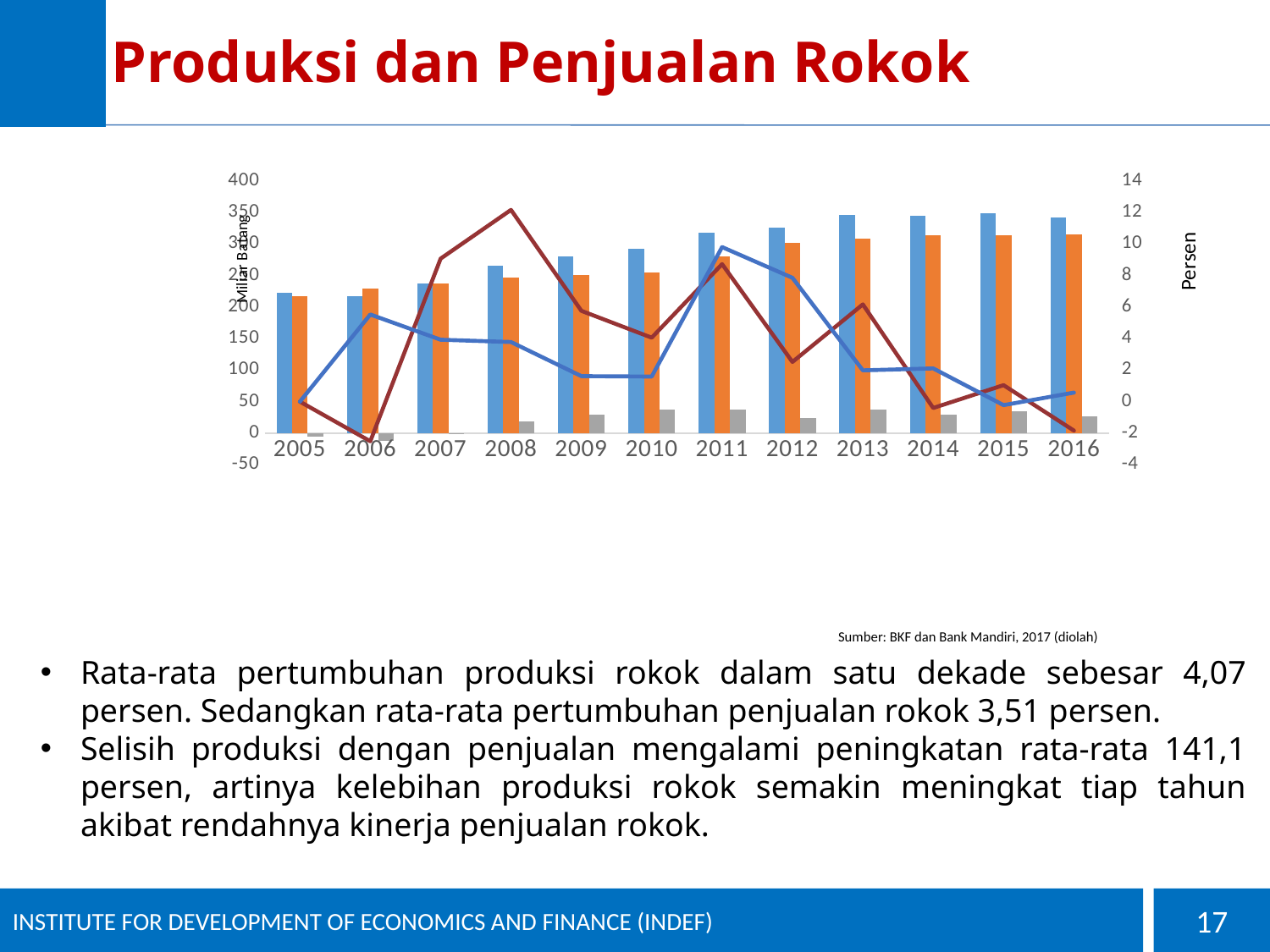
Is the value of the blue bar for 2005 greater or less than 200? greater What is the first year shown on the x axis of the chart? 2005 In which year does the blue line reach its highest point? 2011 Is the value of the gray bar for 2006 greater or less than 0? less Is the value of the blue bar for 2016 greater or less than 300? greater How many years are shown on the x axis of the chart? 12 What kind of chart is shown on the slide? A combination bar and line chart What is the title of the left vertical axis of the chart? Miliar Batang What is the last year shown on the x axis of the chart? 2016 In which year does the dark red line reach its highest point? 2008 Which is larger, the blue bar for 2005 or the blue bar for 2016? 2016